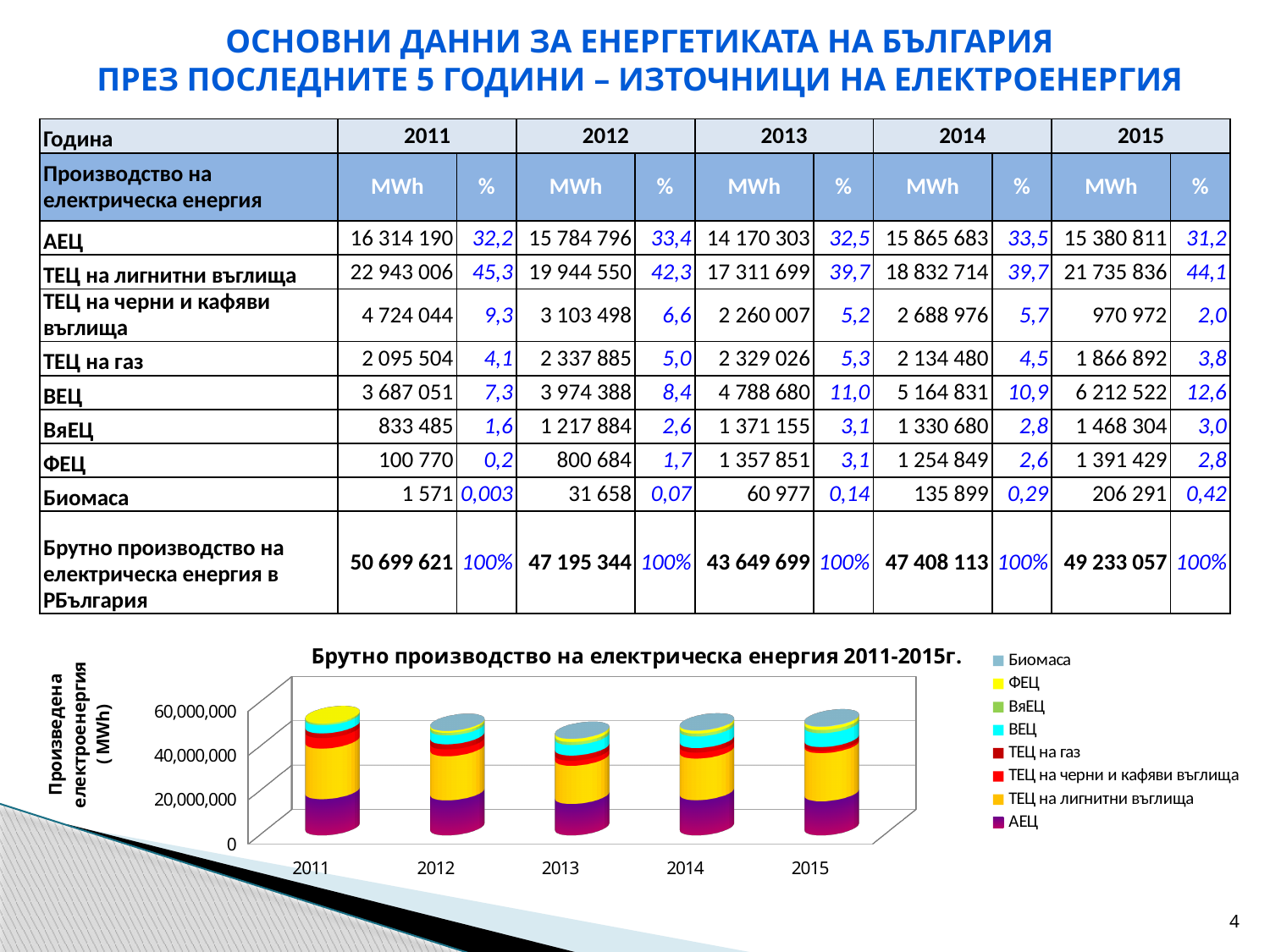
Is the total height of the stacked bar for 2015 greater or less than 20,000,000? greater What kind of chart is shown at the bottom of the slide? Stacked bar chart What is the title of the chart? Брутно производство на електрическа енергия 2011-2015г. How many series does the chart legend list? 8 Which legend entry is shown at the bottom of the legend (the base of each stacked bar)? АЕЦ Which year has the lowest total stacked bar in the chart? 2013 How many years (categories) are plotted on the x axis of the chart? 5 Is the total height of the stacked bar for 2011 greater or less than 40,000,000? greater Is the total height of the stacked bar for 2013 greater or less than 60,000,000? less Do the total stacked bars rise or fall from 2011 to 2013? fall Which year has the highest total stacked bar in the chart? 2011 Is the total stacked bar for 2013 larger or smaller than the one for 2012? smaller